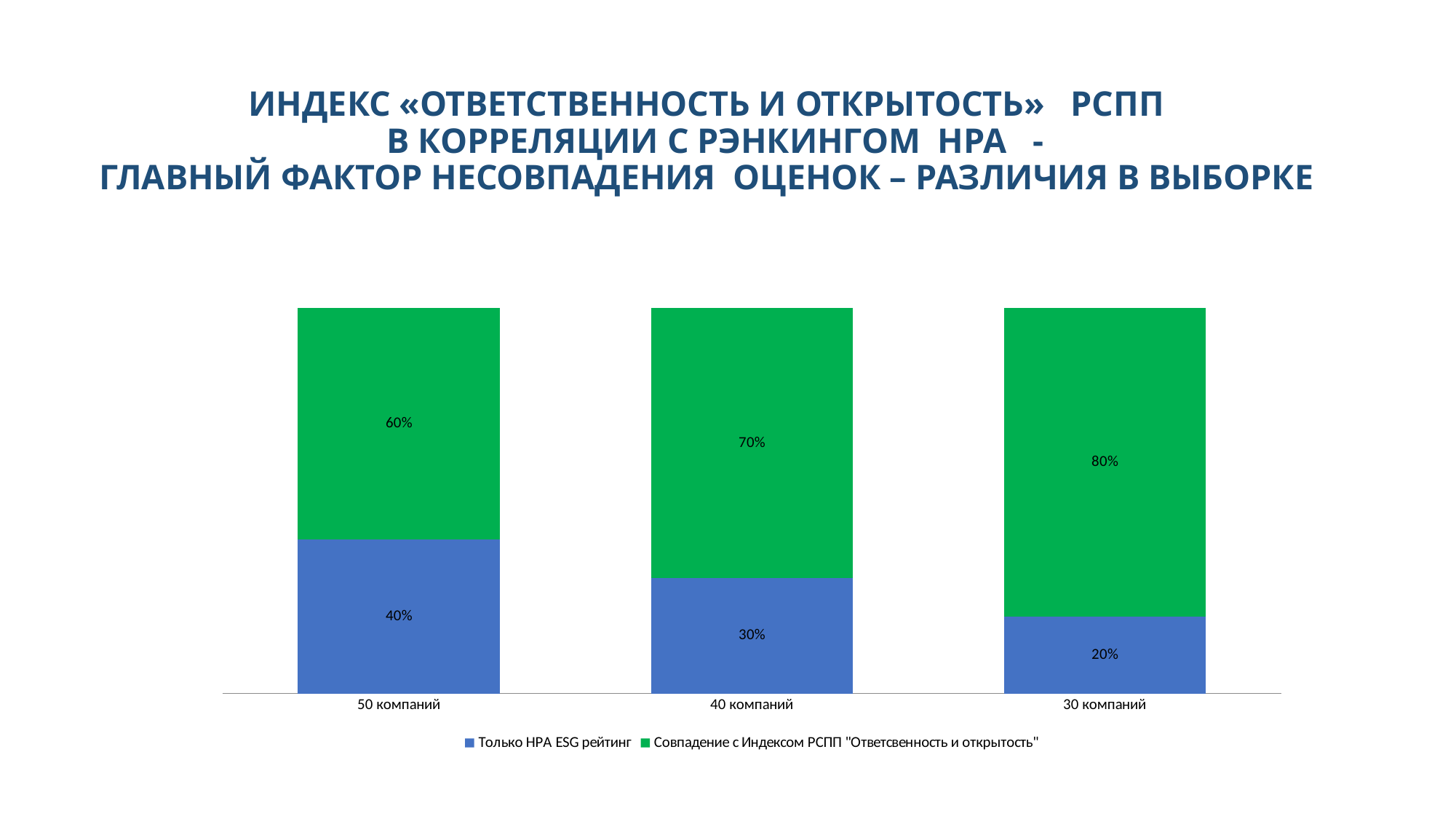
Does the "Только НРА ESG рейтинг" value rise or fall from "50 компаний" to "30 компаний"? Fall How many series does the legend list? 2 What kind of chart is shown on the slide? Stacked bar chart What is the value for "Совпадение с Индексом РСПП "Ответсвенность и открытость"" in the "30 компаний" bar? 80% What is the value for "Только НРА ESG рейтинг" in the "30 компаний" bar? 20% How many categories are shown on the x axis? 3 What is the value for "Совпадение с Индексом РСПП "Ответсвенность и открытость"" in the "40 компаний" bar? 70% What is the difference between the "Совпадение с Индексом РСПП" values for "30 компаний" and "50 компаний"? 20% Which category has the highest value for "Совпадение с Индексом РСПП "Ответсвенность и открытость""? 30 компаний What is the value for "Только НРА ESG рейтинг" in the "50 компаний" bar? 40% Which category has the lowest value for "Только НРА ESG рейтинг"? 30 компаний Which is larger: the "Только НРА ESG рейтинг" value for "50 компаний" or for "40 компаний"? 50 компаний